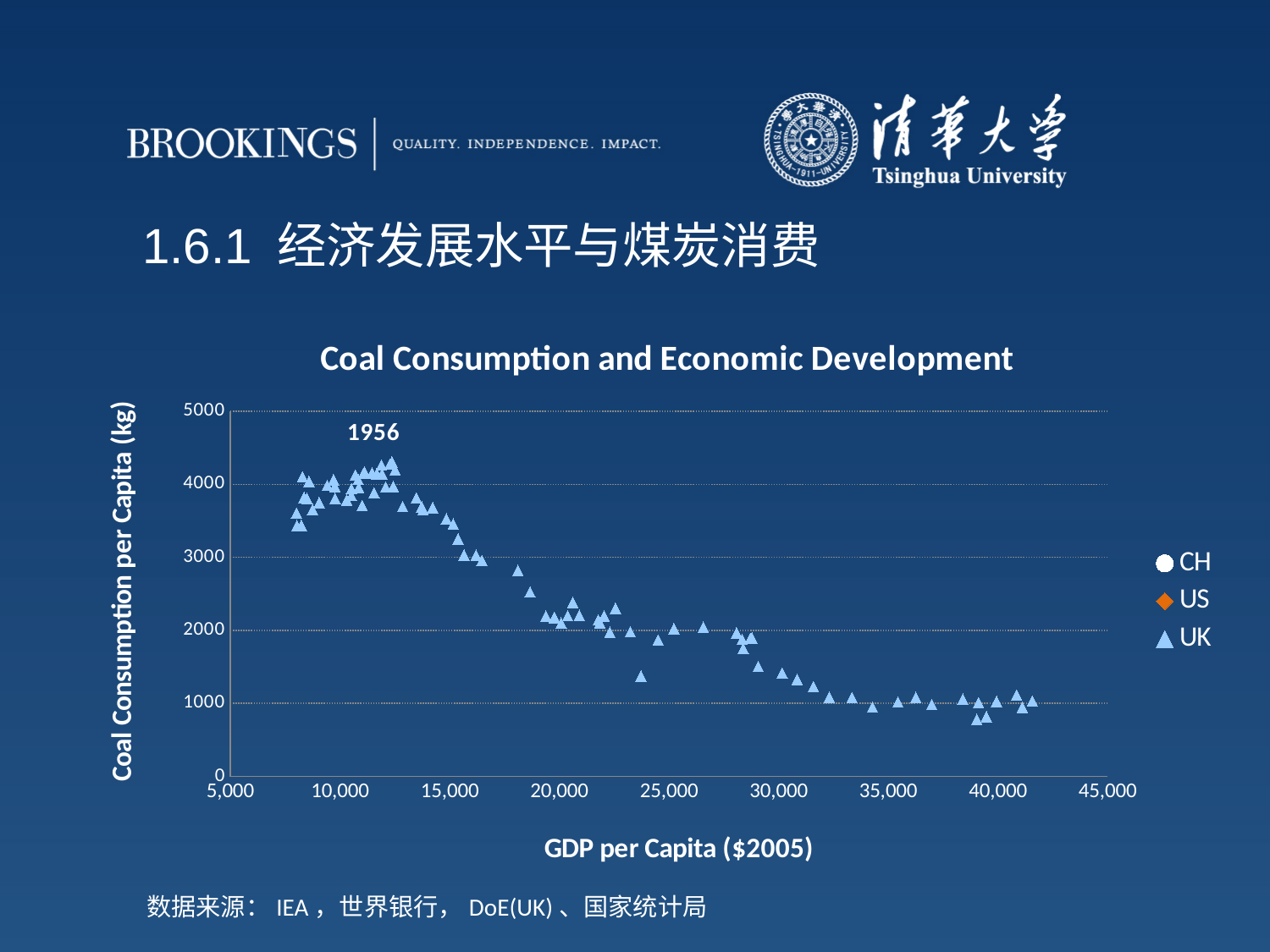
Which year is labeled next to the peak of the UK data points? 1956 Which series is plotted with triangle markers? UK Are the UK coal consumption values at a GDP per capita of about 10,000 greater or less than 3000? greater Are the UK coal consumption values at a GDP per capita of about 30,000 greater or less than 2000? less Are the UK coal consumption values at a GDP per capita of about 40,000 greater or less than 2000? less What is the label of the x axis? GDP per Capita ($2005) What kind of chart is shown on the slide? Scatter chart Which is larger for the UK: coal consumption per capita at a GDP per capita of about 10,000 or at about 40,000? About 10,000 How many series does the legend list? 3 What is the title of the chart? Coal Consumption and Economic Development Overall, does coal consumption per capita for the UK rise or fall as GDP per capita increases? Fall